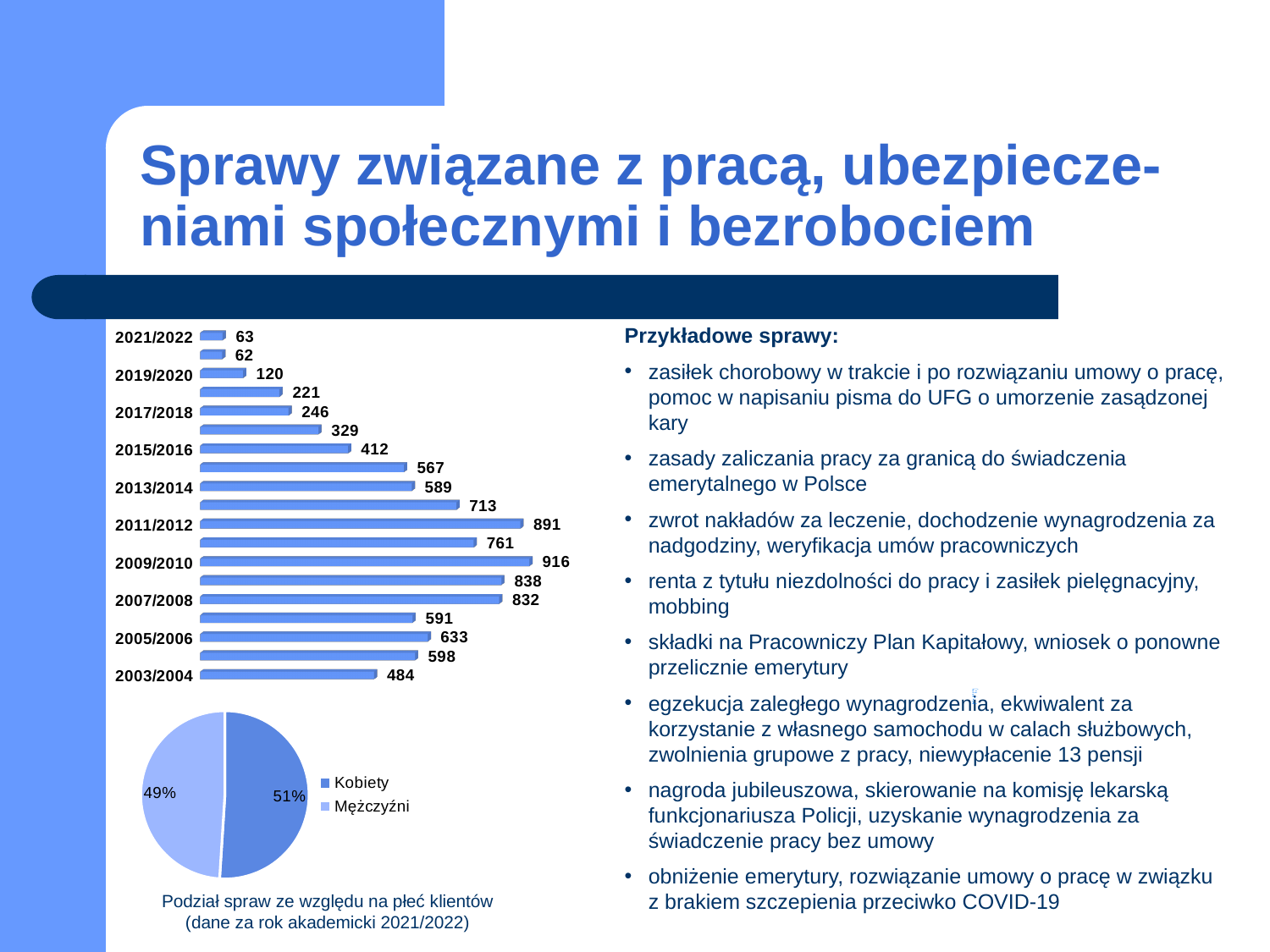
In the pie chart, what share is Kobiety? 51% In the bar chart, what is the difference between the values for 2009/2010 and 2007/2008? 84 How many entries does the legend of the pie chart list? 2 What kind of chart is the chart at the top left of the slide? bar chart In the bar chart, what is the value for 2015/2016? 412 In the bar chart, what is the value for 2009/2010? 916 How many bars are plotted in the bar chart? 19 In the bar chart, what is the value for 2003/2004? 484 In the bar chart, do the values generally rise or fall from 2011/2012 to 2021/2022? fall In the bar chart, which labelled academic year has the highest value? 2009/2010 In the bar chart, which is larger: the value for 2013/2014 or for 2015/2016? 2013/2014 In the bar chart, what is the lowest value printed on any bar? 62